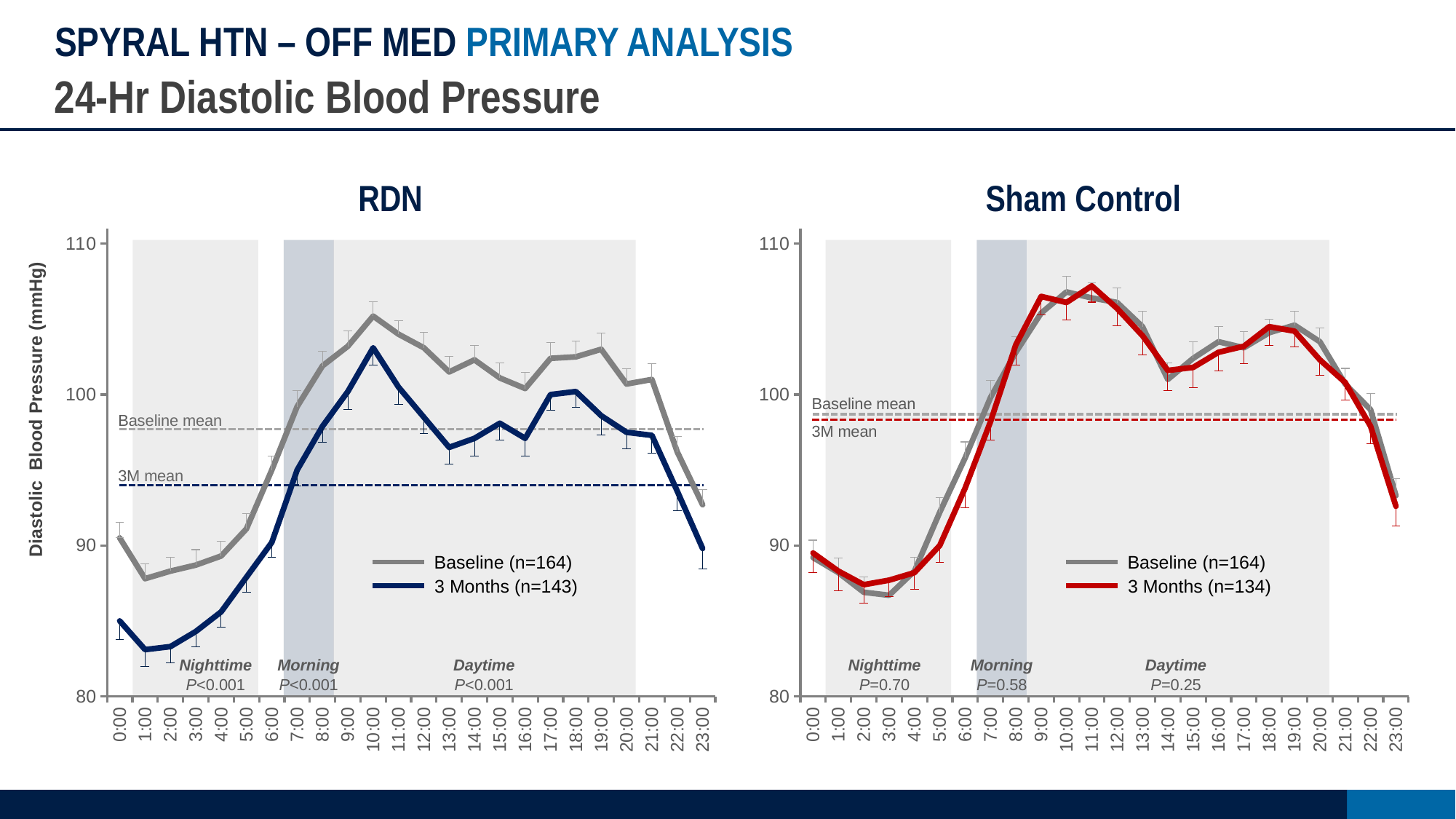
What kind of chart is the RDN chart? line chart In the Sham Control chart, is the Baseline value at 10:00 greater or less than 100? greater In the RDN chart, at what time does the Baseline line reach its highest value? 10:00 In the RDN chart, which series is higher at 13:00, Baseline or 3 Months? Baseline How many time points are shown along the x axis of the Sham Control chart? 24 In the Sham Control chart, what sample size does the legend give for the 3 Months series? n=134 In the RDN chart, does the 3 Months line rise or fall between 6:00 and 10:00? rise In the RDN chart, is the 3 Months value at 1:00 greater or less than 90? less In the RDN chart, what P value is shown for the Nighttime period? P<0.001 In the Sham Control chart, is the 3 Months value at 23:00 greater or less than 90? greater How many series does the legend of the RDN chart list? 2